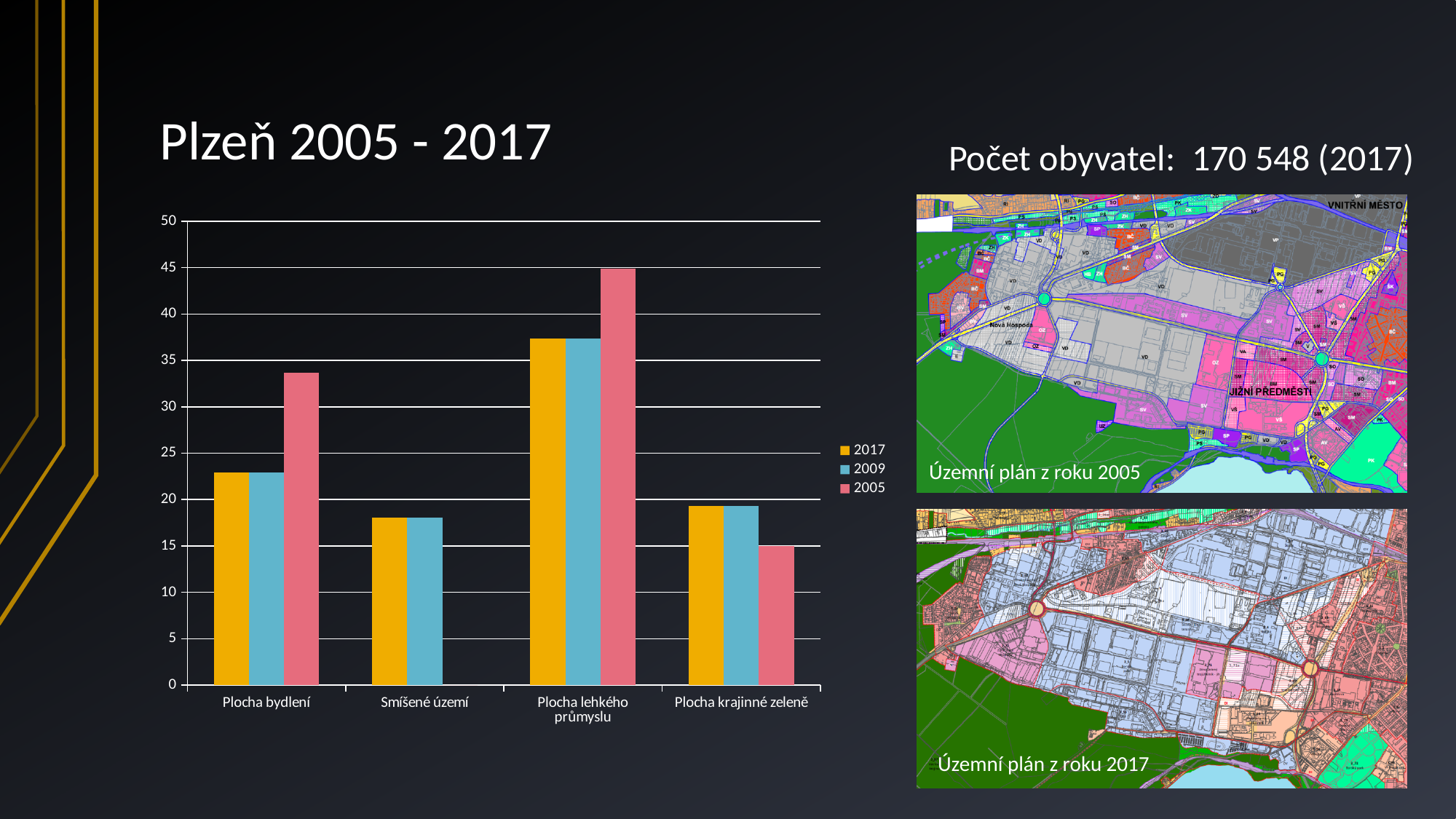
Is the 2017 value for Plocha bydlení greater or less than 25? less Is the 2005 value for Plocha lehkého průmyslu greater or less than 40? greater For Plocha bydlení, which is larger: the 2005 value or the 2009 value? 2005 How many categories are shown on the x axis of the chart? 4 Is the 2005 value for Plocha bydlení greater or less than 30? greater Which category has the highest bar for the 2005 series? Plocha lehkého průmyslu Which category has the lowest bar for the 2017 series? Smíšené území For Plocha krajinné zeleně, which is larger: the 2017 value or the 2005 value? 2017 How many series does the chart legend list? 3 What kind of chart is shown on the slide? bar chart Which category has no bar for the 2005 series? Smíšené území Which series are listed in the chart legend? 2017, 2009, 2005